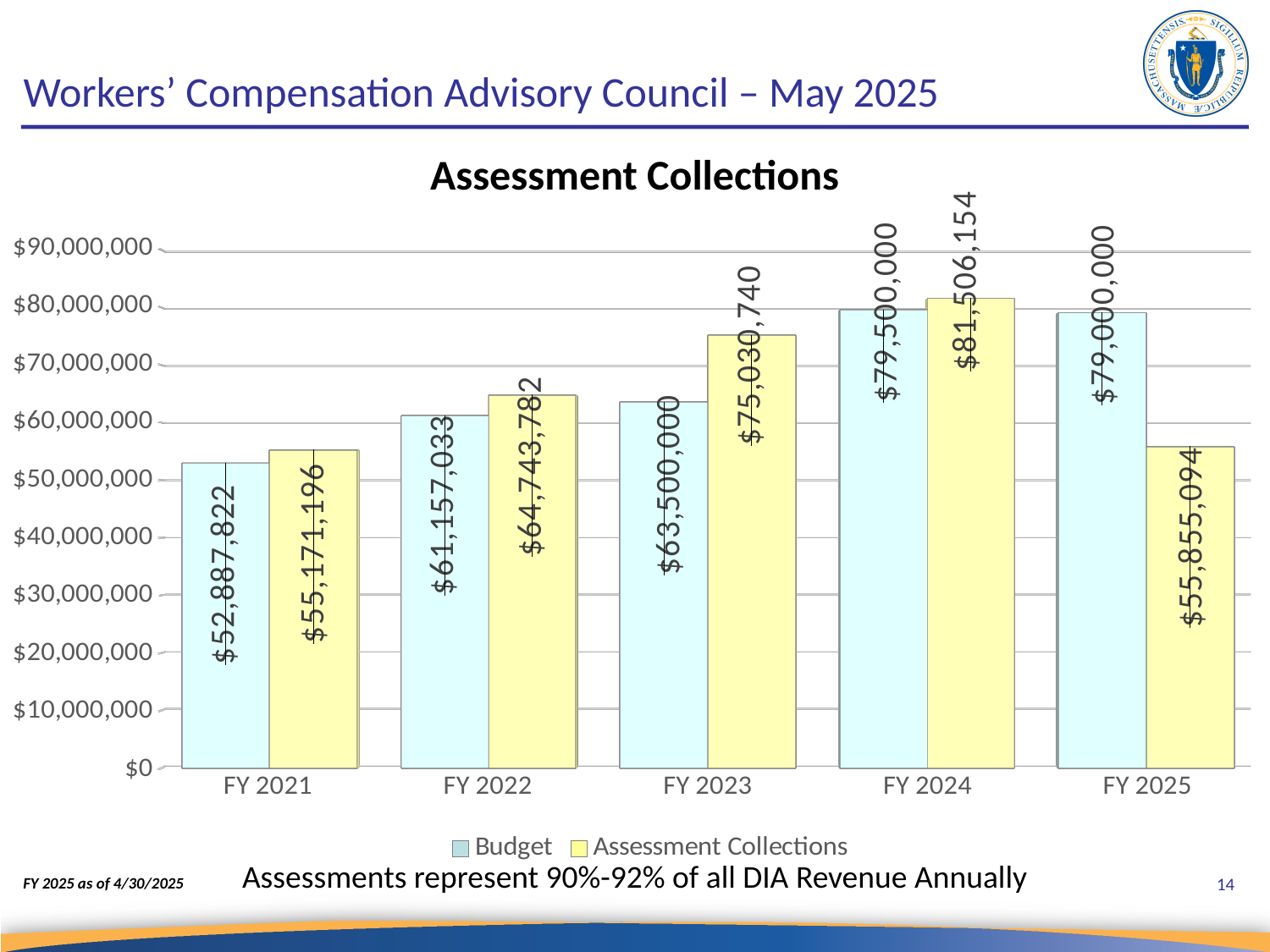
What type of chart is shown on the slide? Bar chart What is the Assessment Collections value for FY 2024? $81,506,154 Is the Assessment Collections value for FY 2022 greater or less than $60,000,000? greater How many series does the legend list? 2 What is the difference between Assessment Collections and Budget in FY 2024? $2,006,154 Which fiscal year has the highest Assessment Collections value? FY 2024 What is the Budget value for FY 2023? $63,500,000 Which fiscal year has the lowest Budget value? FY 2021 By how much does the Budget exceed Assessment Collections in FY 2025? $23,144,906 How many fiscal years are shown on the x axis? 5 In FY 2023, which is larger: Budget or Assessment Collections? Assessment Collections What is the Assessment Collections value for FY 2025? $55,855,094